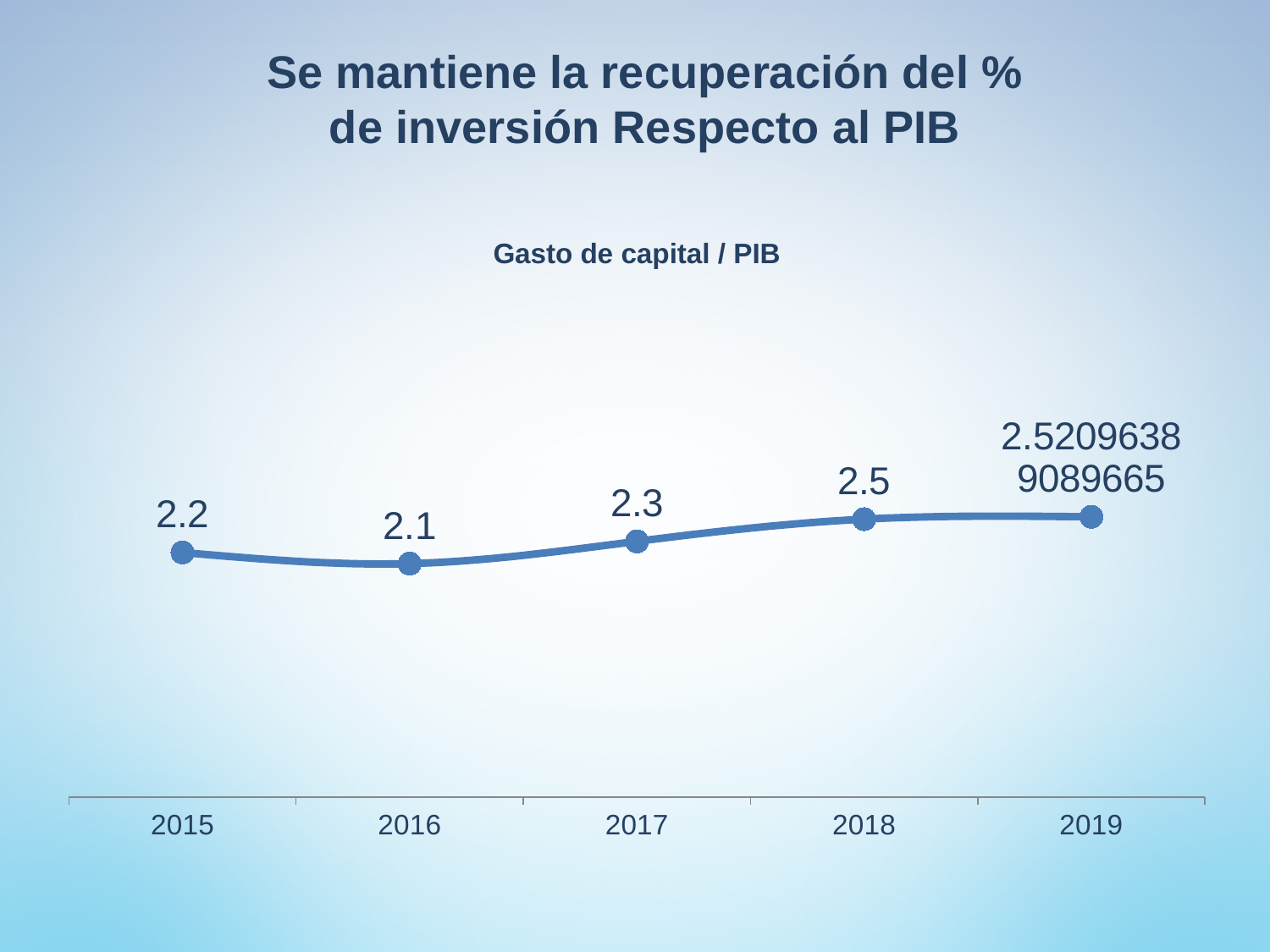
What is the difference between the 2018 and 2016 values in the Gasto de capital / PIB chart? 0.4 What kind of chart is used to show Gasto de capital / PIB? Line chart How many years are plotted in the Gasto de capital / PIB chart? 5 Which year has the lowest value in the Gasto de capital / PIB chart? 2016 What is the value for 2016 in the Gasto de capital / PIB chart? 2.1 What is the value for 2015 in the Gasto de capital / PIB chart? 2.2 Which year has the highest value in the Gasto de capital / PIB chart? 2019 What is the data label shown for 2019 in the Gasto de capital / PIB chart? 2.52096389089665 What is the value for 2018 in the Gasto de capital / PIB chart? 2.5 What is the value for 2017 in the Gasto de capital / PIB chart? 2.3 Do the values in the Gasto de capital / PIB chart rise or fall from 2016 to 2019? Rise Which year has the larger value in the Gasto de capital / PIB chart, 2016 or 2017? 2017